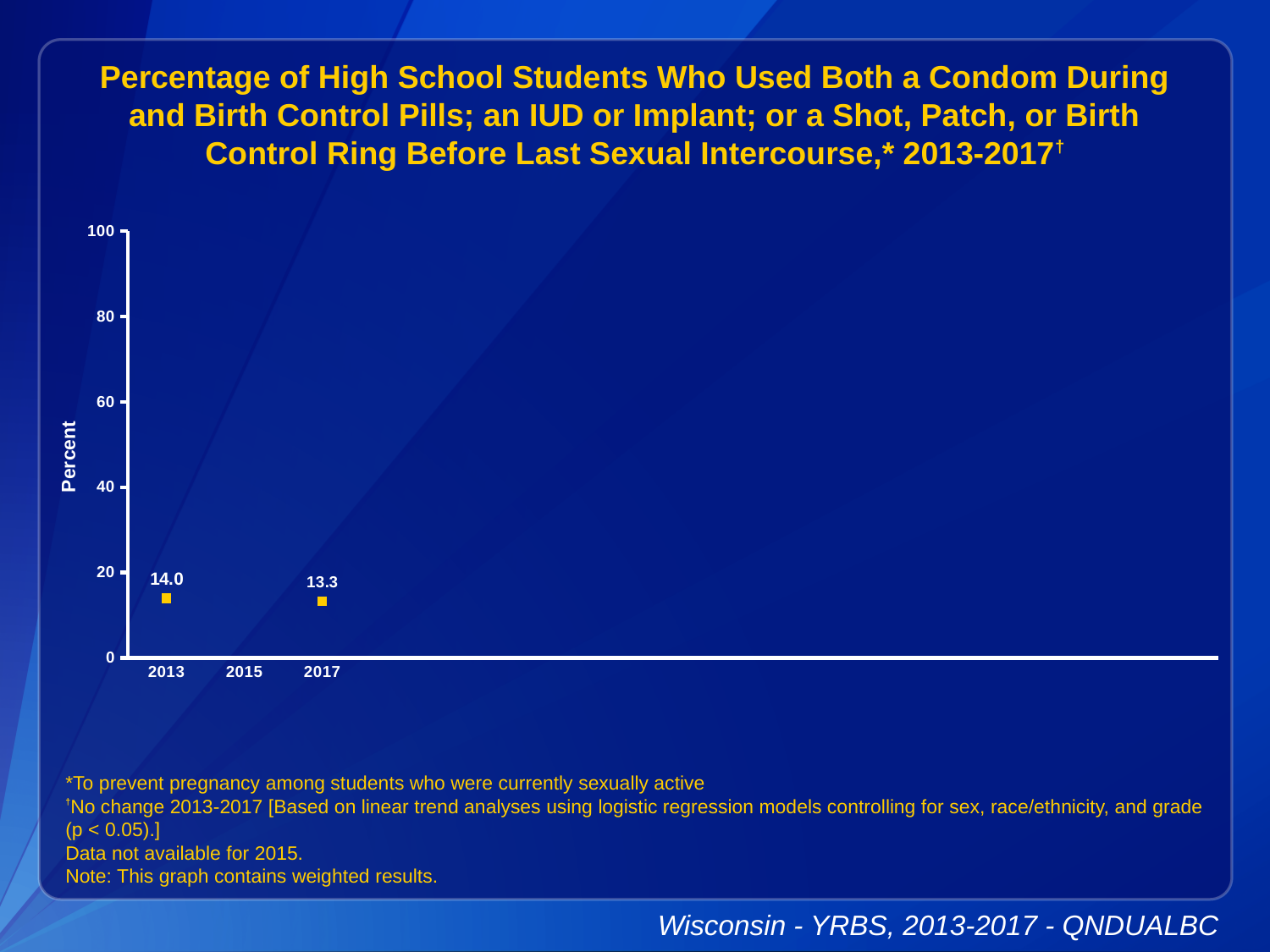
What is the value for 2013? 14.0 Which is larger, the value for 2013 or the value for 2017? 2013 For which year on the x axis is no data plotted? 2015 Which year has the highest value? 2013 Do the values rise or fall from 2013 to 2017? fall Which year has the lowest plotted value? 2017 How many data points are plotted on the chart? 2 What is the label on the y axis? Percent What is the difference between the values for 2013 and 2017? 0.7 Is the value for 2013 greater or less than 20? less Is the value for 2017 greater or less than 40? less What is the value for 2017? 13.3